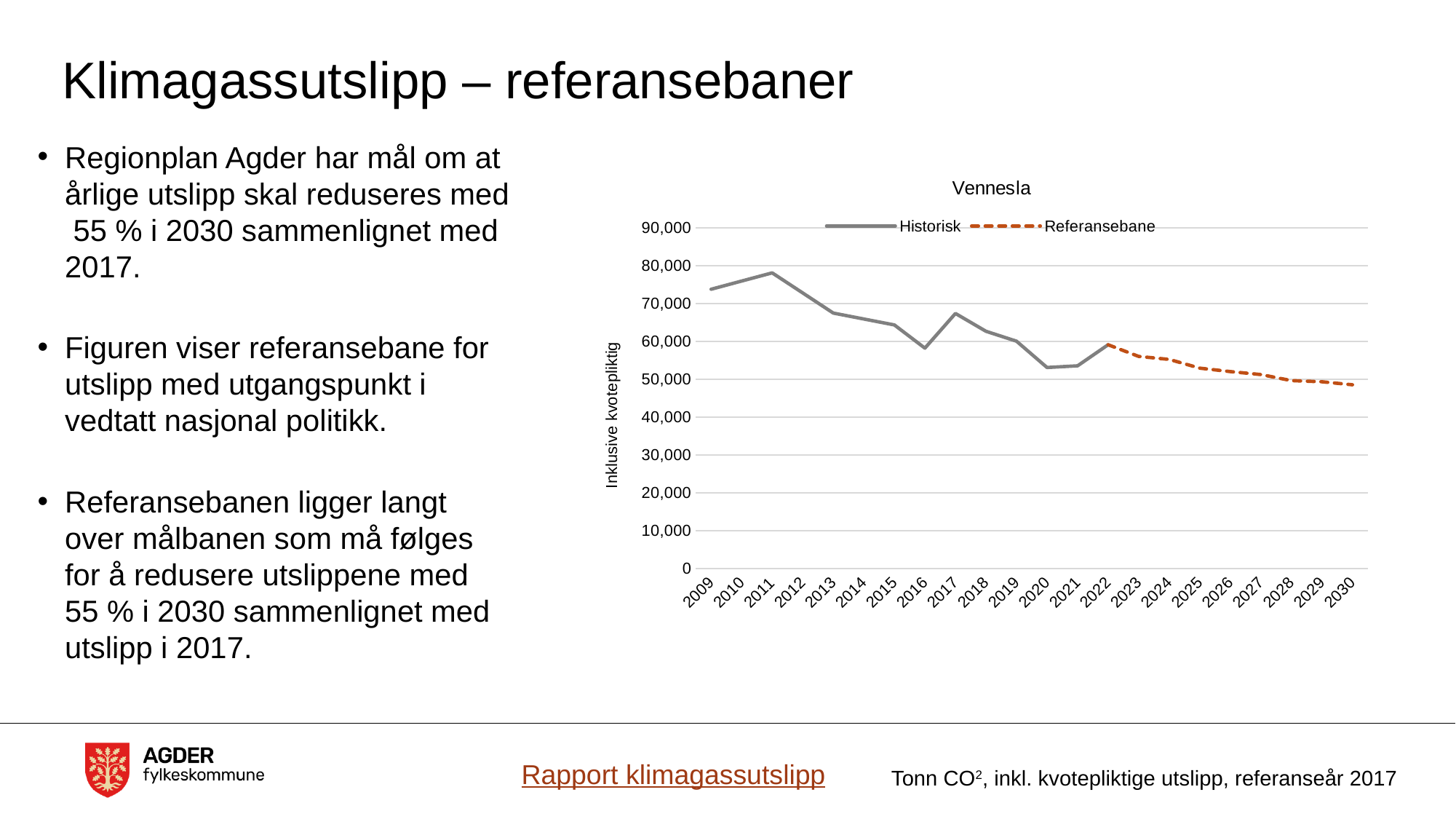
Is the Historisk value for 2011 greater or less than 70,000? greater Does the Referansebane series rise or fall from 2022 to 2030? Fall What kind of chart is shown on the slide? Line chart In which year does the Historisk series reach its highest value? 2011 What is the label on the vertical axis of the chart? Inklusive kvotepliktig Which year has the larger Historisk value, 2011 or 2016? 2011 Is the Historisk value for 2016 greater or less than 60,000? less How many series does the chart legend list? 2 Is the Referansebane value for 2030 greater or less than 50,000? less What is the title of the chart? Vennesla How many years are shown along the x axis of the chart? 22 In which year does the Referansebane series reach its lowest value? 2030